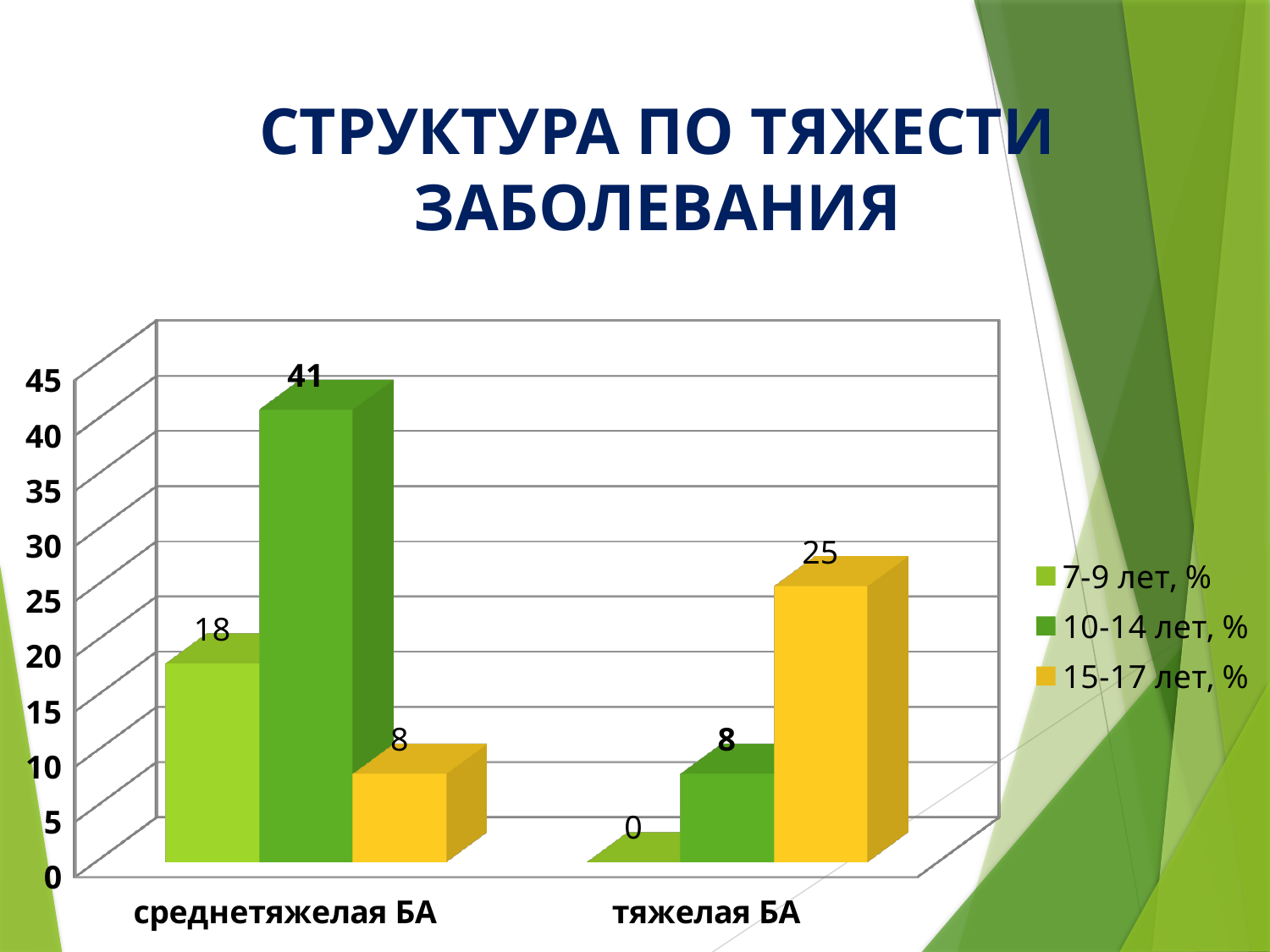
What is the value for 15-17 лет, % in the тяжелая БА category? 25 How many series does the legend list? 3 What is the title of the slide? СТРУКТУРА ПО ТЯЖЕСТИ ЗАБОЛЕВАНИЯ What is the difference between the 10-14 лет, % values for среднетяжелая БА and тяжелая БА? 33 How many categories are shown on the x axis? 2 Which series has the highest value in the среднетяжелая БА category? 10-14 лет, % What kind of chart is shown on the slide? bar chart What is the value for 7-9 лет, % in the среднетяжелая БА category? 18 Which is larger: the 15-17 лет, % value for среднетяжелая БА or for тяжелая БА? тяжелая БА Which series has the lowest value in the тяжелая БА category? 7-9 лет, % What is the value for 10-14 лет, % in the среднетяжелая БА category? 41 What is the value for 7-9 лет, % in the тяжелая БА category? 0